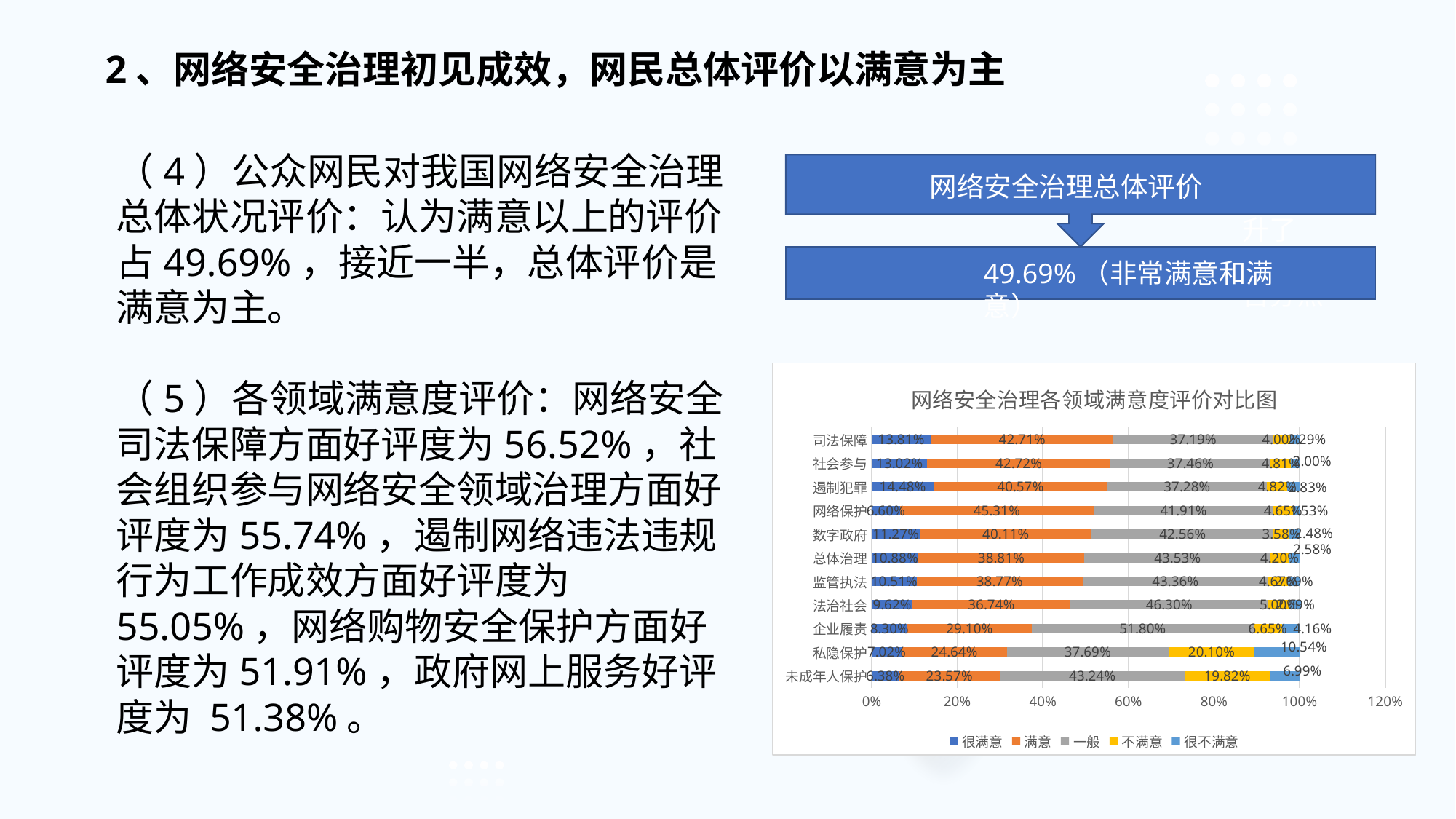
How many series does the legend of the chart list? 5 What is the 一般 value for 企业履责? 51.80% How many categories are plotted in the chart 网络安全治理各领域满意度评价对比图? 11 What is the 很满意 value for 司法保障? 13.81% What is the 满意 value for 网络保护? 45.31% Which category has the highest 一般 value? 企业履责 What kind of chart is shown on the slide? Stacked bar chart Which has the larger 不满意 value, 私隐保护 or 企业履责? 私隐保护 What is the 不满意 value for 私隐保护? 20.10% Which category has the lowest 很满意 value? 未成年人保护 Which category has the highest 很满意 value? 遏制犯罪 What is the difference between the 满意 values for 网络保护 and 未成年人保护? 21.74%